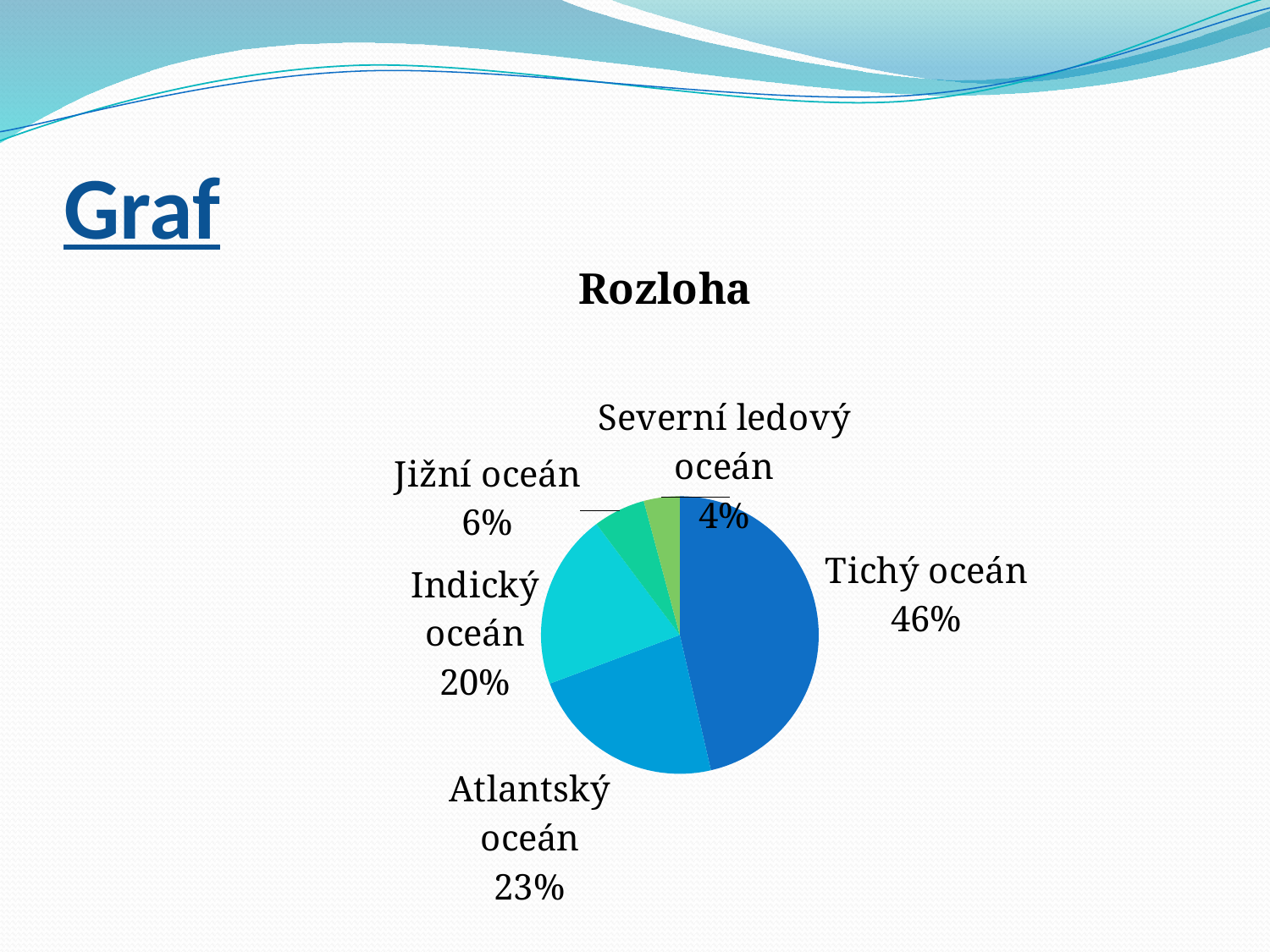
What share of the pie does Atlantský oceán have? 23% What is the title of the chart? Rozloha What share of the pie does Severní ledový oceán have? 4% Which ocean has the smallest slice of the pie? Severní ledový oceán What type of chart is shown on the slide? pie chart Which ocean has the largest slice of the pie? Tichý oceán What share of the pie does Jižní oceán have? 6% Which is larger, the share for Indický oceán or the share for Atlantský oceán? Atlantský oceán How many slices does the pie chart have? 5 What is the difference in percentage points between Tichý oceán and Atlantský oceán? 23